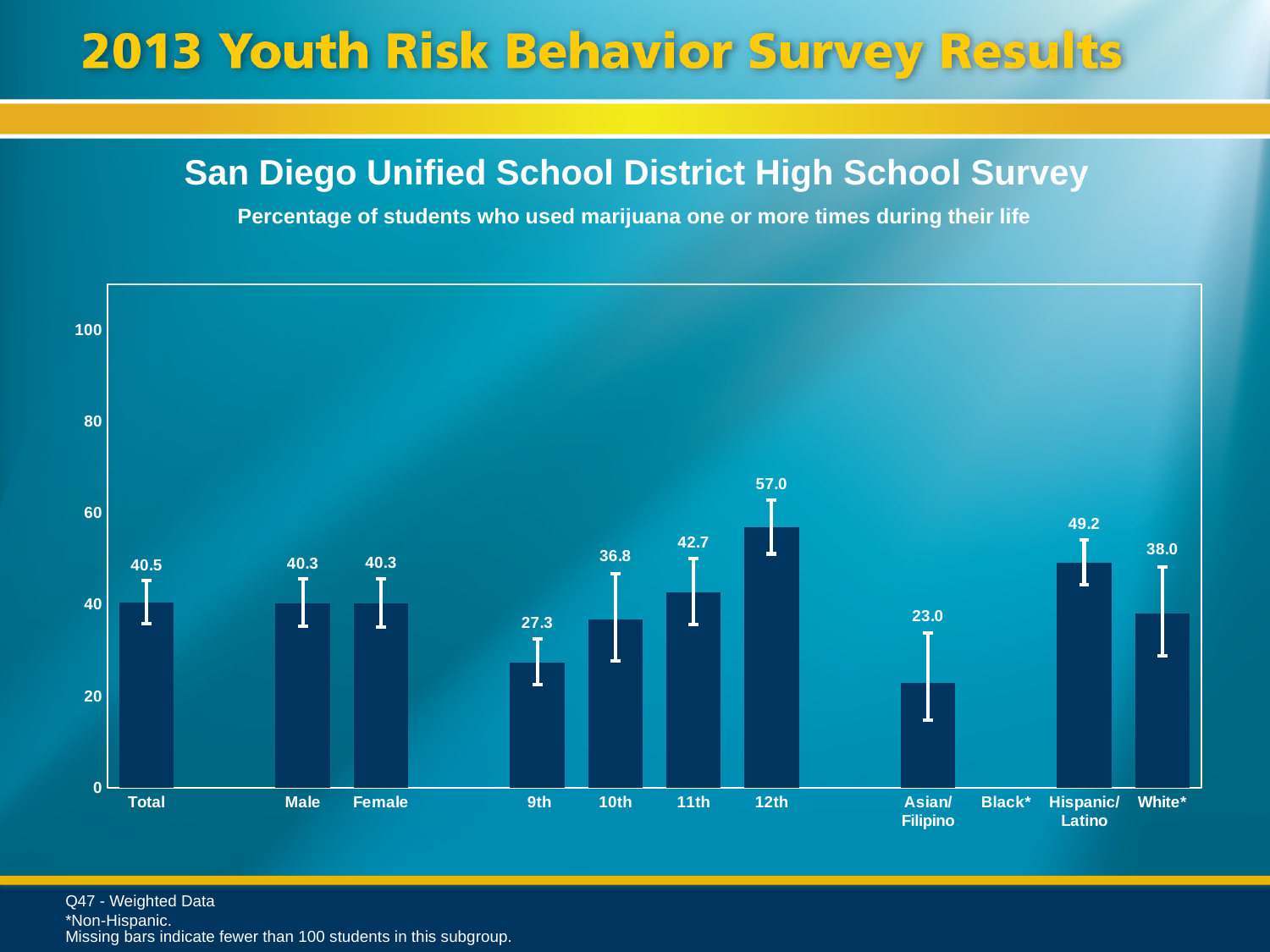
Which category has the highest value? 12th How many category labels are shown on the x axis? 11 What is the value for the Total category? 40.5 Which category with a plotted bar has the lowest value? Asian/Filipino Which category label has no bar plotted? Black* What is the value for 12th grade students? 57.0 What is the difference between the values for 12th and 9th grade? 29.7 Which is larger, the value for Hispanic/Latino or the value for White*? Hispanic/Latino What is the value for Asian/Filipino students? 23.0 What kind of chart is shown? bar chart Is the value for 11th grade greater or less than 40? greater Do the values rise or fall from 9th grade to 12th grade? rise